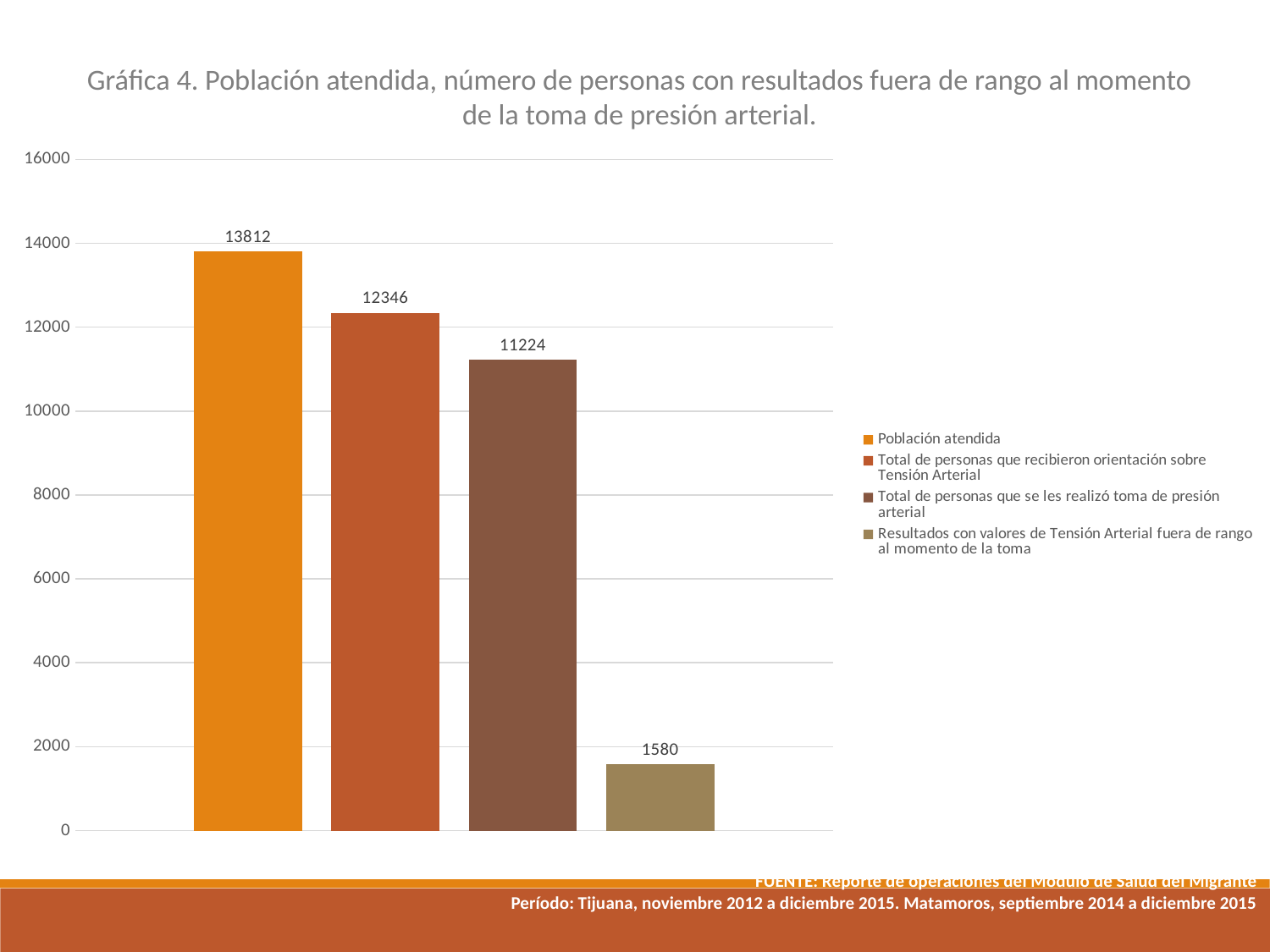
What kind of chart is shown on the slide? Bar chart Which series has the lowest value? Resultados con valores de Tensión Arterial fuera de rango al momento de la toma Which is larger: Total de personas que recibieron orientación sobre Tensión Arterial or Total de personas que se les realizó toma de presión arterial? Total de personas que recibieron orientación sobre Tensión Arterial What is the title of the chart? Gráfica 4. Población atendida, número de personas con resultados fuera de rango al momento de la toma de presión arterial. What is the value for Total de personas que se les realizó toma de presión arterial? 11224 Which series has the highest value? Población atendida What is the value for Resultados con valores de Tensión Arterial fuera de rango al momento de la toma? 1580 What is the difference between Total de personas que se les realizó toma de presión arterial and Resultados con valores de Tensión Arterial fuera de rango al momento de la toma? 9644 What is the difference between Población atendida and Total de personas que recibieron orientación sobre Tensión Arterial? 1466 How many series does the legend list? 4 What is the value for Total de personas que recibieron orientación sobre Tensión Arterial? 12346 What is the value for Población atendida? 13812